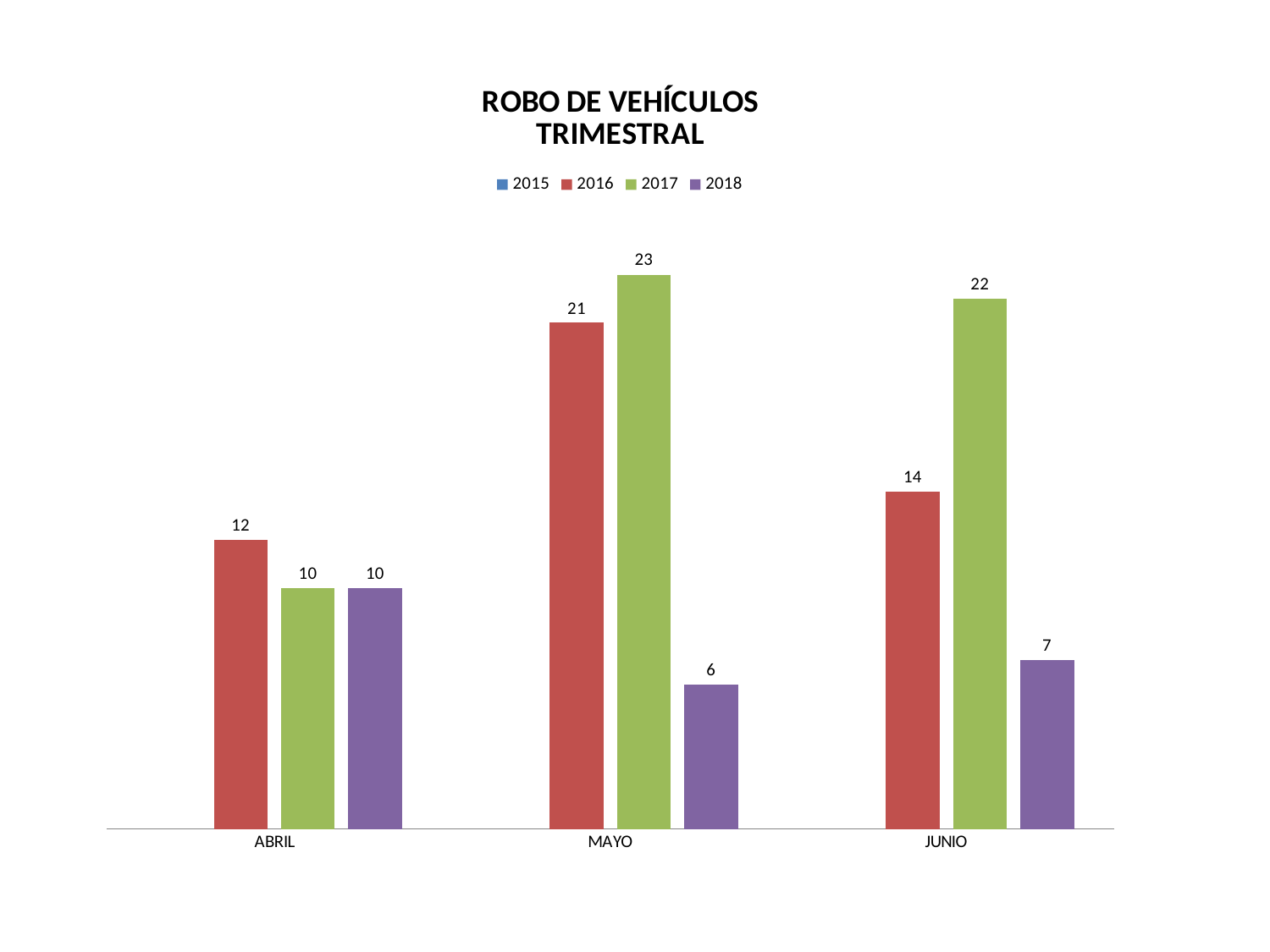
What is the value for 2018 in MAYO? 6 What is the value for 2018 in ABRIL? 10 What is the difference between the 2017 and 2018 values in JUNIO? 15 What is the value for 2016 in JUNIO? 14 What is the value for 2017 in MAYO? 23 How many months are shown on the x axis? 3 What kind of chart is this? Bar chart Which is larger in ABRIL, the 2016 value or the 2017 value? 2016 How many series does the legend list? 4 In which month is the 2018 value lowest? MAYO What is the difference between the 2017 and 2016 values in MAYO? 2 In which month is the 2017 value highest? MAYO